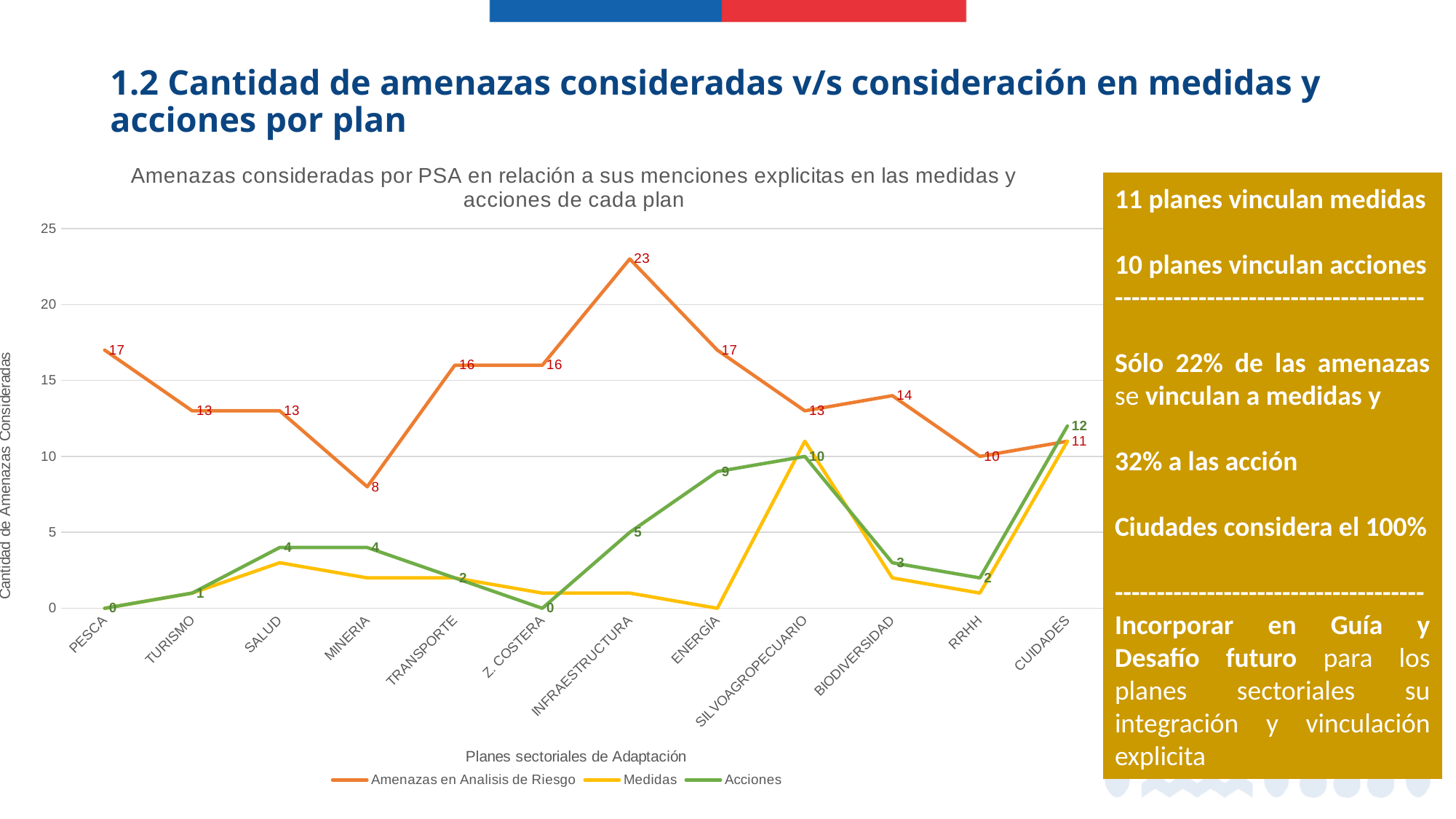
Which plan has the lowest value for Amenazas en Analisis de Riesgo? MINERIA What type of chart is shown on the slide? line chart Is the value of Medidas for SILVOAGROPECUARIO greater or less than 10? greater What is the difference between Amenazas en Analisis de Riesgo and Acciones for ENERGÍA? 8 Which plan has the highest value for Acciones? CUIDADES What is the value of Amenazas en Analisis de Riesgo for INFRAESTRUCTURA? 23 What is the value of Acciones for SILVOAGROPECUARIO? 10 How many series does the chart legend list? 3 Which is larger for BIODIVERSIDAD: Amenazas en Analisis de Riesgo or Acciones? Amenazas en Analisis de Riesgo Which plan has the highest value for Amenazas en Analisis de Riesgo? INFRAESTRUCTURA How many sectoral plans (categories) are shown on the x axis? 12 Which series is drawn in green in the chart? Acciones